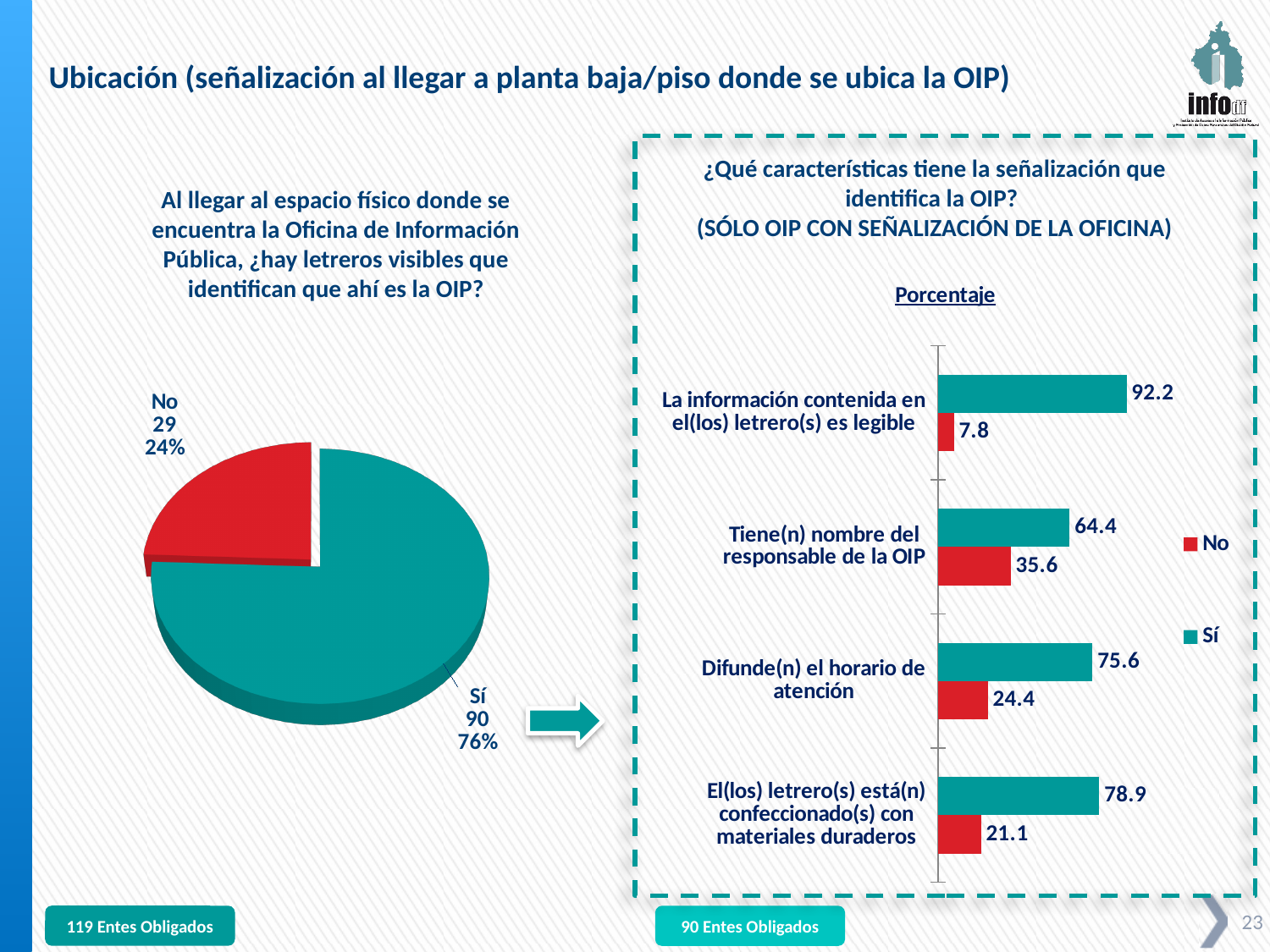
In the bar chart on the right, what is the "No" value for "Tiene(n) nombre del responsable de la OIP"? 35.6 In the bar chart on the right, what is the "Sí" value for "La información contenida en el(los) letrero(s) es legible"? 92.2 In the pie chart on the left, what percentage answered "Sí"? 76% In the bar chart on the right, which category has the lowest "Sí" value? Tiene(n) nombre del responsable de la OIP In the bar chart on the right, which category has the highest "Sí" value? La información contenida en el(los) letrero(s) es legible What type of chart is on the right side of the slide? Bar chart In the pie chart on the left, what is the difference in count between "Sí" and "No"? 61 In the pie chart on the left, how many entities answered "No"? 29 In the pie chart on the left, which slice is larger, "Sí" or "No"? Sí In the bar chart on the right, how many series does the legend list? 2 In the bar chart on the right, how many categories are shown? 4 In the bar chart on the right, what is the difference between the "Sí" and "No" values for "Difunde(n) el horario de atención"? 51.2